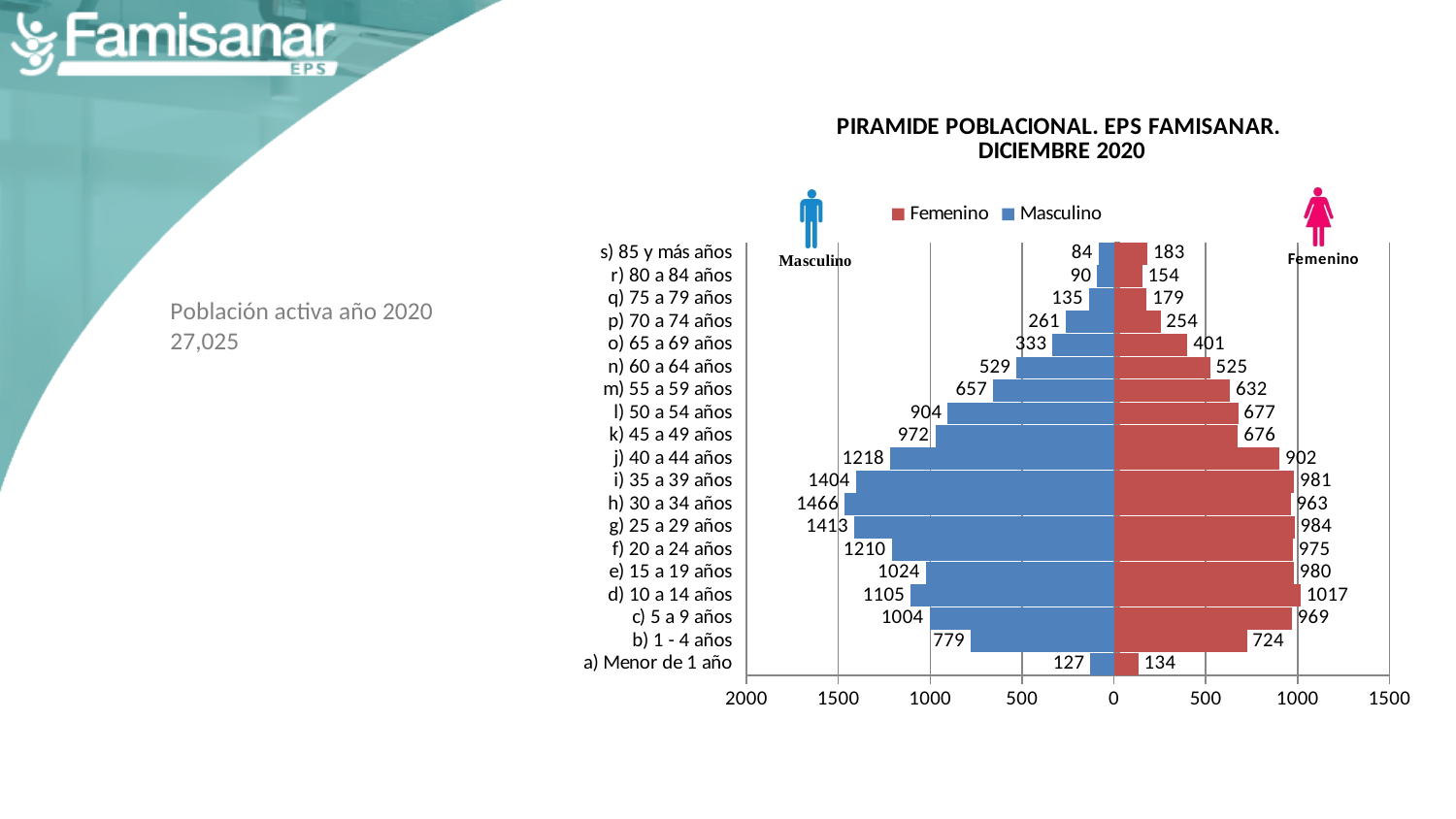
How many age groups are shown on the chart? 19 Which age group has the highest Femenino value? d) 10 a 14 años What is the Femenino value for the age group s) 85 y más años? 183 What is the Masculino value for the age group h) 30 a 34 años? 1466 What type of chart is shown on the slide? bar chart (population pyramid) What is the Femenino value for the age group d) 10 a 14 años? 1017 What is the title of the chart? PIRAMIDE POBLACIONAL. EPS FAMISANAR. DICIEMBRE 2020 How many series does the legend list? 2 Which age group has the lowest Masculino value? s) 85 y más años Which is larger for the age group o) 65 a 69 años, the Masculino value or the Femenino value? Femenino Which age group has the highest Masculino value? h) 30 a 34 años What is the difference between the Masculino and Femenino values for h) 30 a 34 años? 503